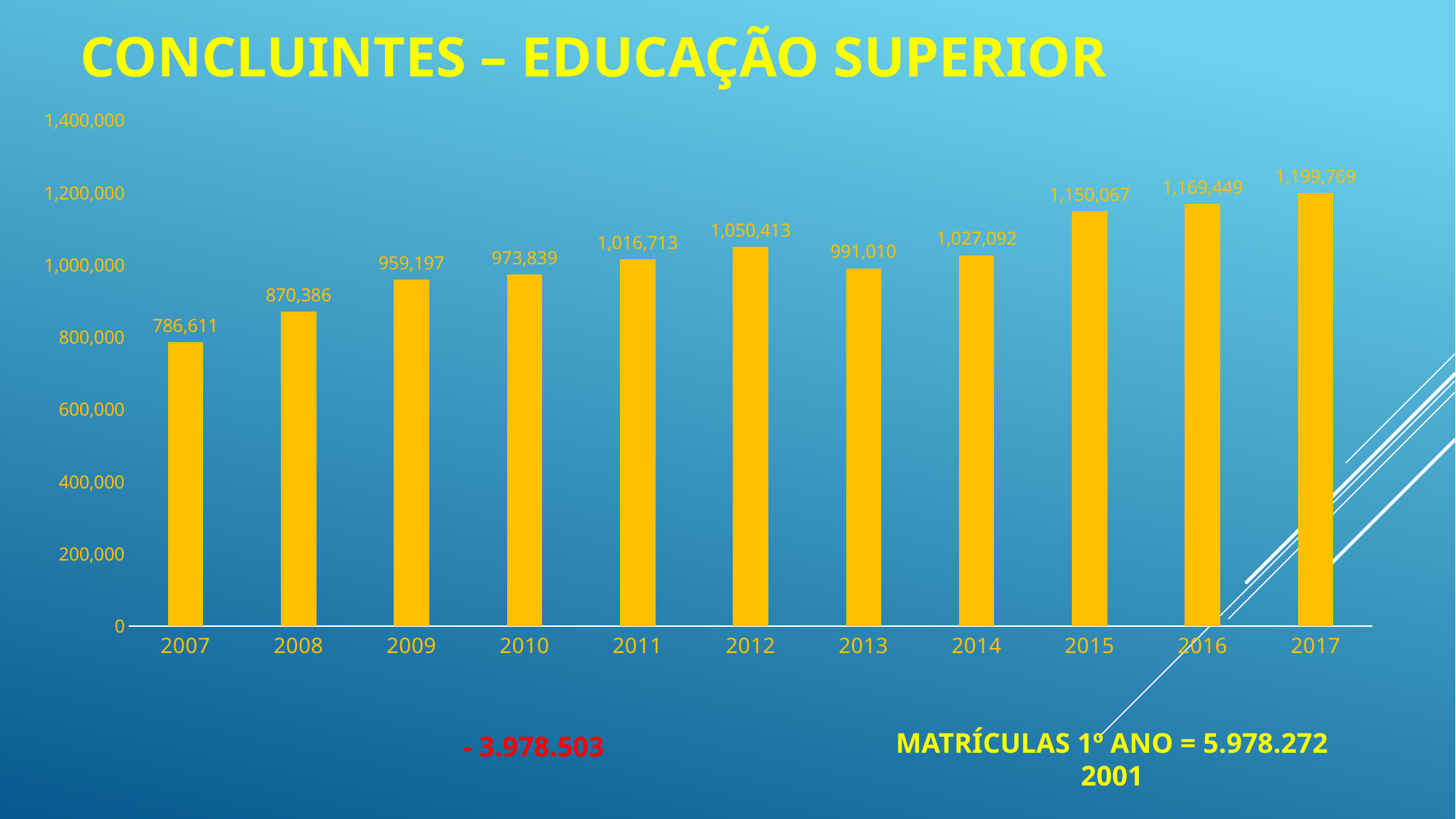
What is the title of the chart? CONCLUINTES – EDUCAÇÃO SUPERIOR What kind of chart is shown on the slide? bar chart Which year has the highest value? 2017 What is the value for 2007? 786,611 What is the difference between the values for 2012 and 2013? 59,403 Which is larger, the value for 2012 or the value for 2013? 2012 Which year has the lowest value? 2007 How many years are shown on the x axis? 11 What is the difference between the values for 2017 and 2007? 413,158 What is the value for 2013? 991,010 Is the value for 2010 greater or less than 1,000,000? less What is the value for 2017? 1,199,769